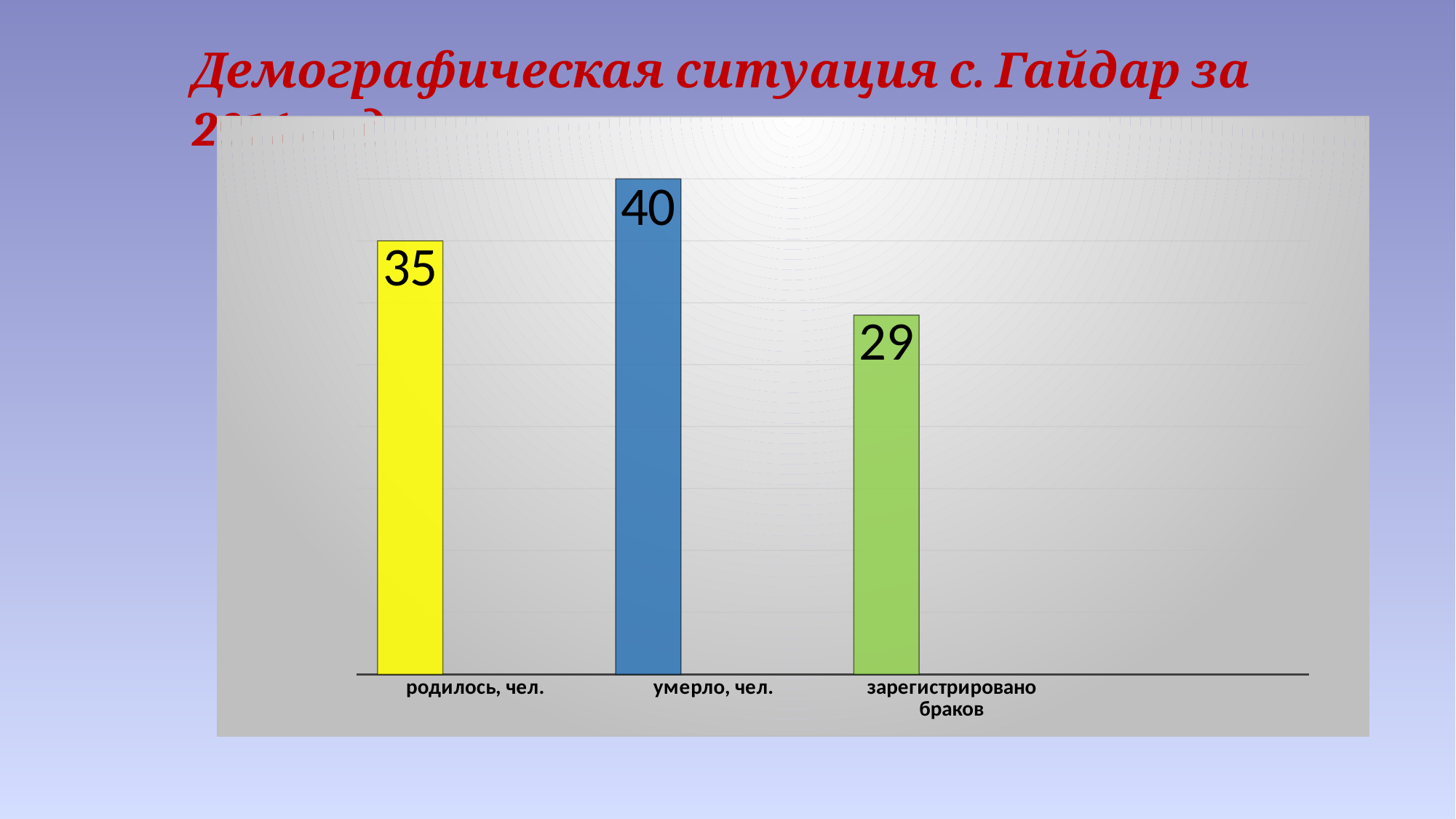
What is the value for зарегистрировано браков? 29 What is the difference between the values for умерло, чел. and родилось, чел.? 5 What colour is the bar for родилось, чел.? yellow Which category has the lowest value? зарегистрировано браков How many categories are shown in the chart? 3 What kind of chart is shown on the slide? bar chart Which is larger, the value for родилось, чел. or the value for умерло, чел.? умерло, чел. Which category has the highest value? умерло, чел. What is the difference between the values for родилось, чел. and зарегистрировано браков? 6 What is the value for родилось, чел.? 35 What is the value for умерло, чел.? 40 What colour is the bar for умерло, чел.? blue